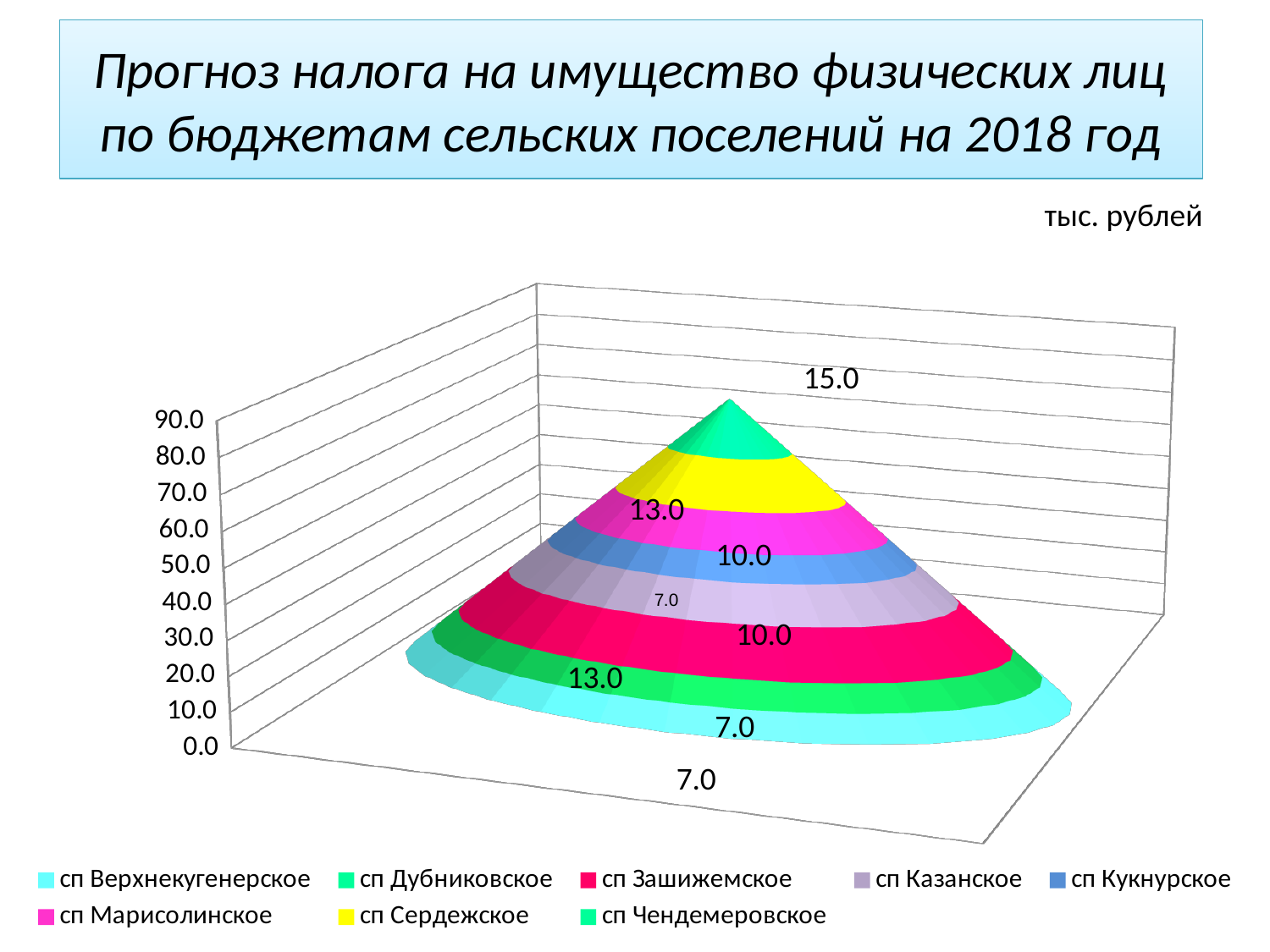
Is the total of the stacked segments greater or less than 90.0? less How many segments have a data label of 7.0? 3 What is the value for сп Верхнекугенерское? 7.0 Which series has the highest value? сп Чендемеровское What is the total of all the stacked segments? 82.0 What is the difference between the value for сп Чендемеровское and the value for сп Верхнекугенерское? 8.0 What is the highest tick value shown on the vertical axis? 90.0 What is the value for сп Чендемеровское? 15.0 How many series does the legend list? 8 Which is larger, the value for сп Чендемеровское or the value for сп Верхнекугенерское? сп Чендемеровское In what units are the values on the chart given? тыс. рублей What kind of chart is shown on the slide? stacked bar chart